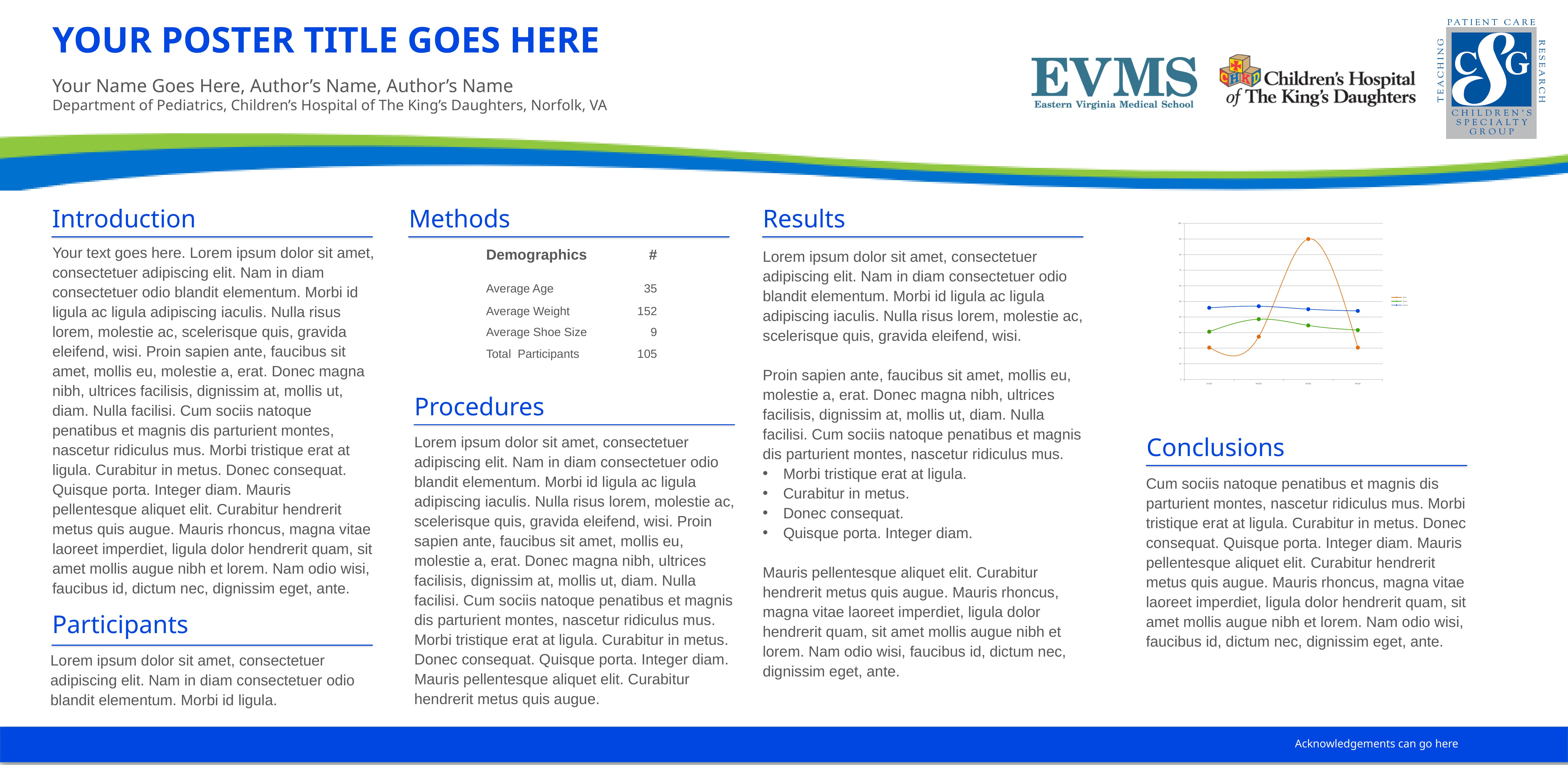
Where is the legend positioned in the line chart? to the right of the plot area At the third point on the x axis, which line is higher in the line chart, the orange line or the blue line? the orange line How many series does the legend of the line chart list? 3 Does the orange line in the line chart rise or fall between its second and third points? rise What colours are the three lines in the line chart? blue, orange and green At which point along the x axis does the orange line in the line chart peak? the third point How many data points does each line in the line chart have? 4 Which coloured line in the line chart contains the lowest point? the orange line At the first point on the x axis, which line is higher in the line chart, the blue line or the green line? the blue line What kind of chart is shown in the top-right of the slide? line chart Which coloured line in the line chart reaches the highest point? the orange line Does the orange line in the line chart rise or fall between its third and fourth points? fall